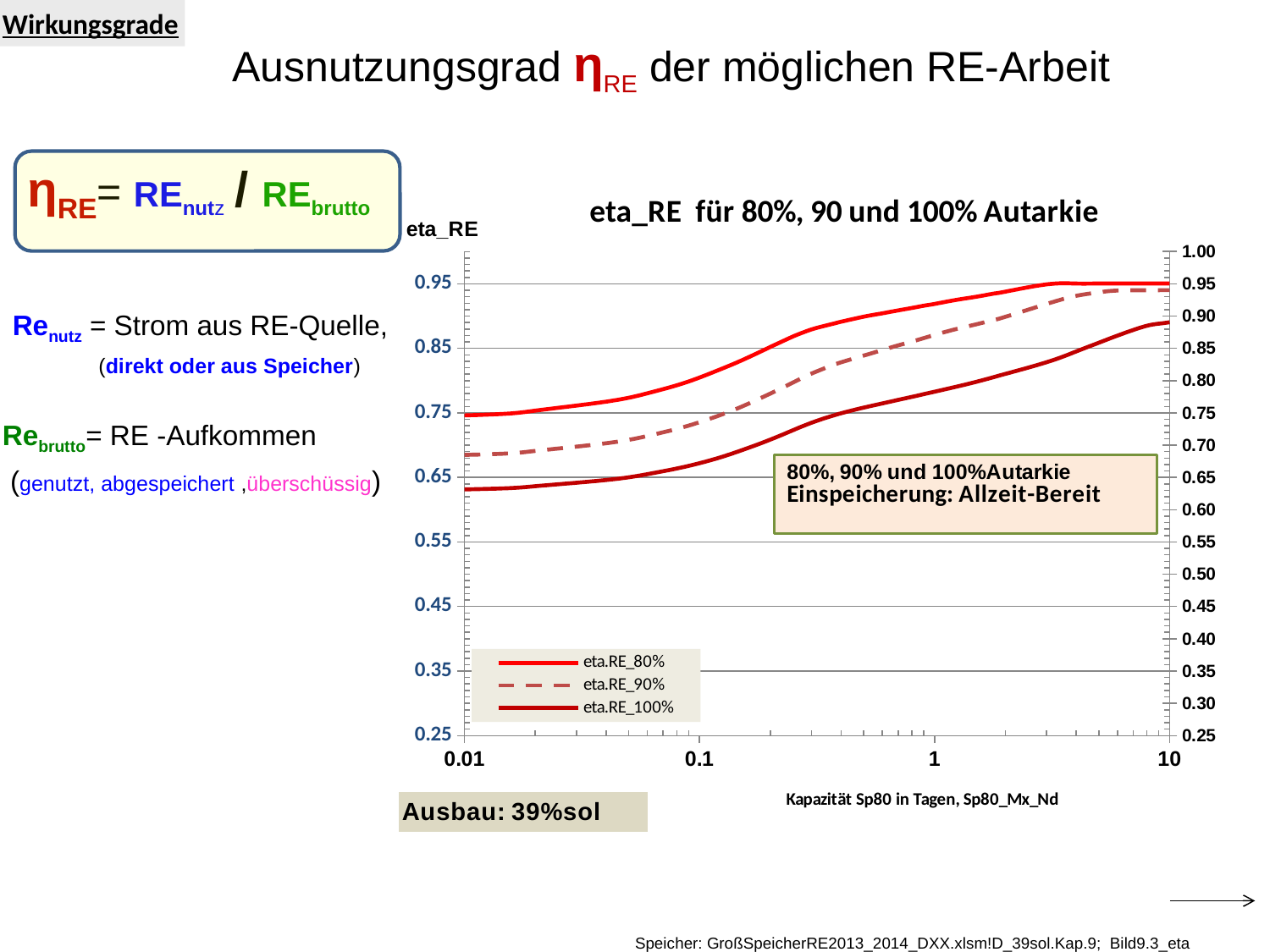
At x = 0.1, which series has the larger value, eta.RE_80% or eta.RE_100%? eta.RE_80% What kind of chart is shown on the slide? line chart Is the value of the eta.RE_100% series at x = 0.01 greater or less than 0.70? less Which series in the chart is drawn with a dashed line? eta.RE_90% Do the values of the eta.RE_100% series rise or fall along the x axis? rise How many series does the chart legend list? 3 Do the values of the eta.RE_80% series rise or fall as the x axis increases from 0.01 to 10? rise What is the title of the chart? eta_RE für 80%, 90 und 100% Autarkie Is the value of the eta.RE_90% series at x = 10 greater or less than 0.90? greater Which series has the lowest values across the whole x axis range? eta.RE_100% Which series has the highest values across the whole x axis range? eta.RE_80% Is the value of the eta.RE_100% series at x = 10 greater or less than 0.85? greater